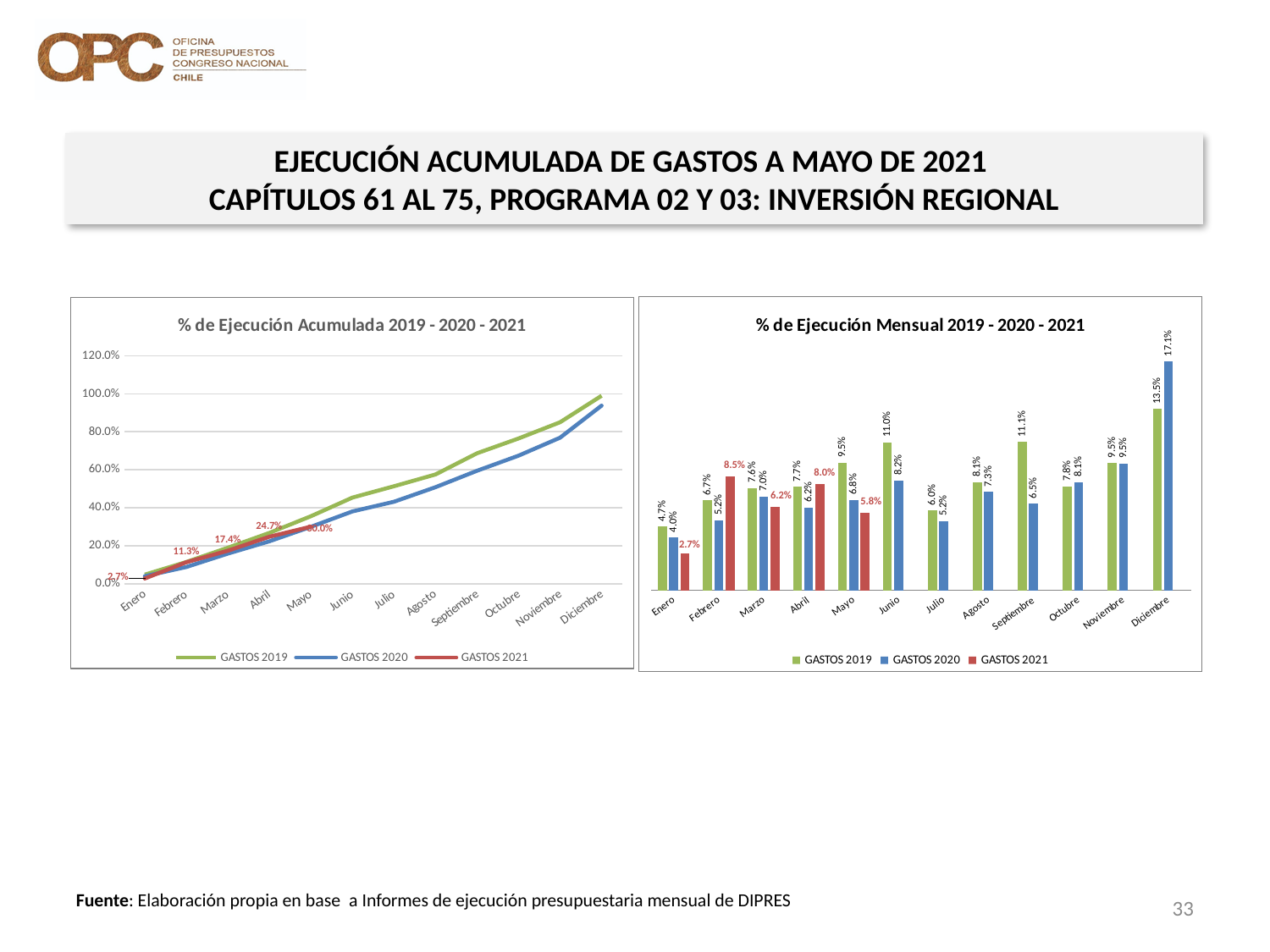
In the chart titled '% de Ejecución Acumulada 2019 - 2020 - 2021', what is the difference between the GASTOS 2021 values for Mayo and Abril? 5.3% What kind of chart is the one titled '% de Ejecución Mensual 2019 - 2020 - 2021'? Bar chart In the chart titled '% de Ejecución Mensual 2019 - 2020 - 2021', what is the difference between GASTOS 2020 and GASTOS 2019 in Diciembre? 3.6% In the chart titled '% de Ejecución Mensual 2019 - 2020 - 2021', which month has the lowest value for GASTOS 2021? Enero In the chart titled '% de Ejecución Acumulada 2019 - 2020 - 2021', how many series does the legend list? 3 In the chart titled '% de Ejecución Mensual 2019 - 2020 - 2021', which is larger in Abril: GASTOS 2019 or GASTOS 2021? GASTOS 2021 In the chart titled '% de Ejecución Mensual 2019 - 2020 - 2021', what is the value for GASTOS 2021 in Febrero? 8.5% In the chart titled '% de Ejecución Mensual 2019 - 2020 - 2021', what is the value for GASTOS 2020 in Diciembre? 17.1% What kind of chart is the one titled '% de Ejecución Acumulada 2019 - 2020 - 2021'? Line chart In the chart titled '% de Ejecución Acumulada 2019 - 2020 - 2021', is the value for GASTOS 2020 in Diciembre greater or less than 80.0%? greater In the chart titled '% de Ejecución Acumulada 2019 - 2020 - 2021', what is the value for GASTOS 2021 in Mayo? 30.0% In the chart titled '% de Ejecución Mensual 2019 - 2020 - 2021', which month has the highest value for GASTOS 2019? Diciembre